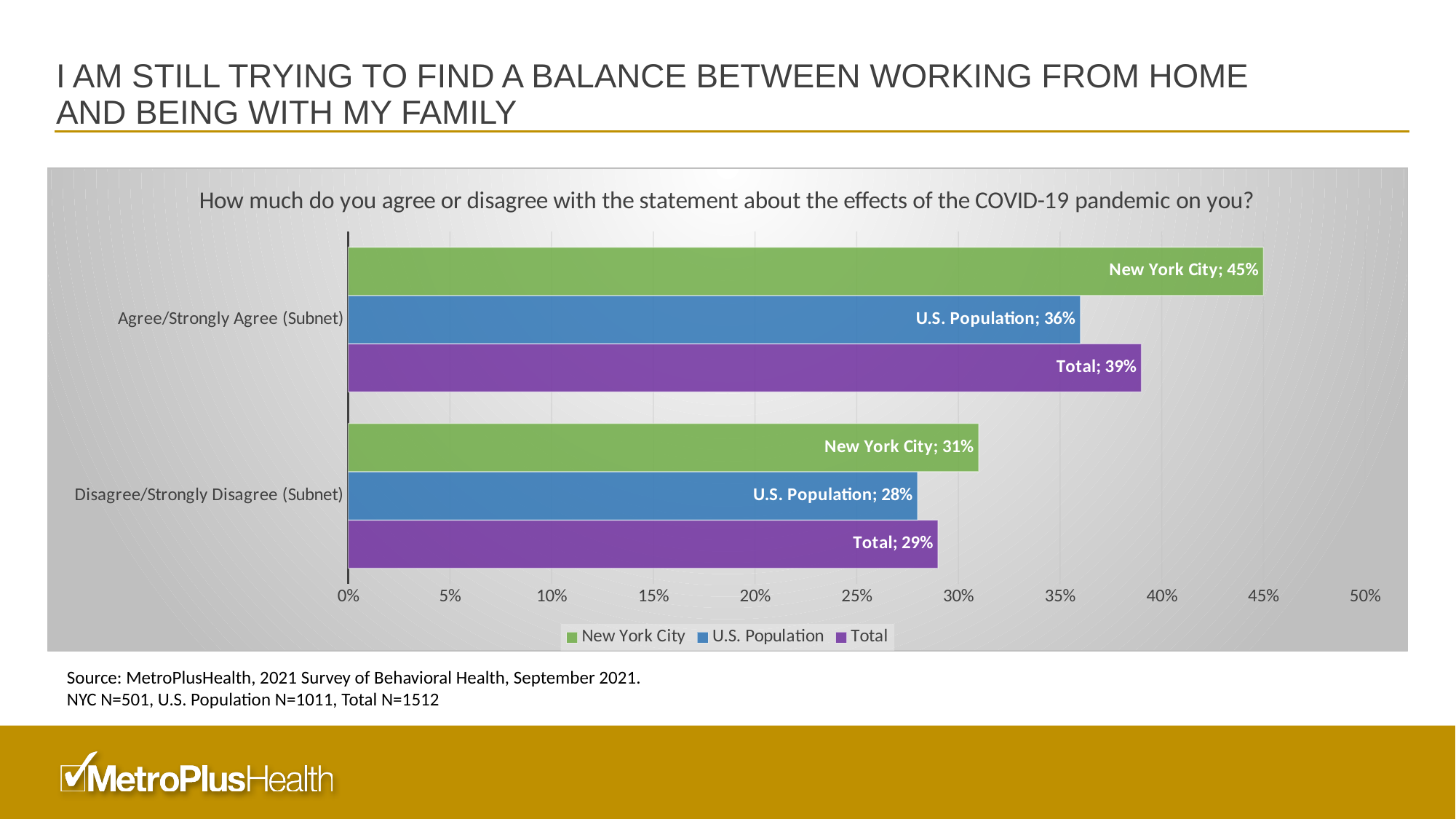
What is the U.S. Population value for Disagree/Strongly Disagree (Subnet)? 28% What colour represents the Total series in the chart? Purple What is the Total value for Agree/Strongly Agree (Subnet)? 39% What kind of chart is shown on the slide? Bar chart How many series does the legend list? 3 Which is larger: the New York City value for Disagree/Strongly Disagree or the U.S. Population value for Agree/Strongly Agree? U.S. Population value for Agree/Strongly Agree What percentage of New York City respondents Agree/Strongly Agree with the statement? 45% How many response categories are shown on the vertical axis? 2 What is the difference between the New York City and U.S. Population values for Agree/Strongly Agree (Subnet)? 9% Which series has the lowest value for Disagree/Strongly Disagree (Subnet)? U.S. Population What is the difference between the Total values for Agree/Strongly Agree and Disagree/Strongly Disagree? 10% Which series has the highest value for Agree/Strongly Agree (Subnet)? New York City